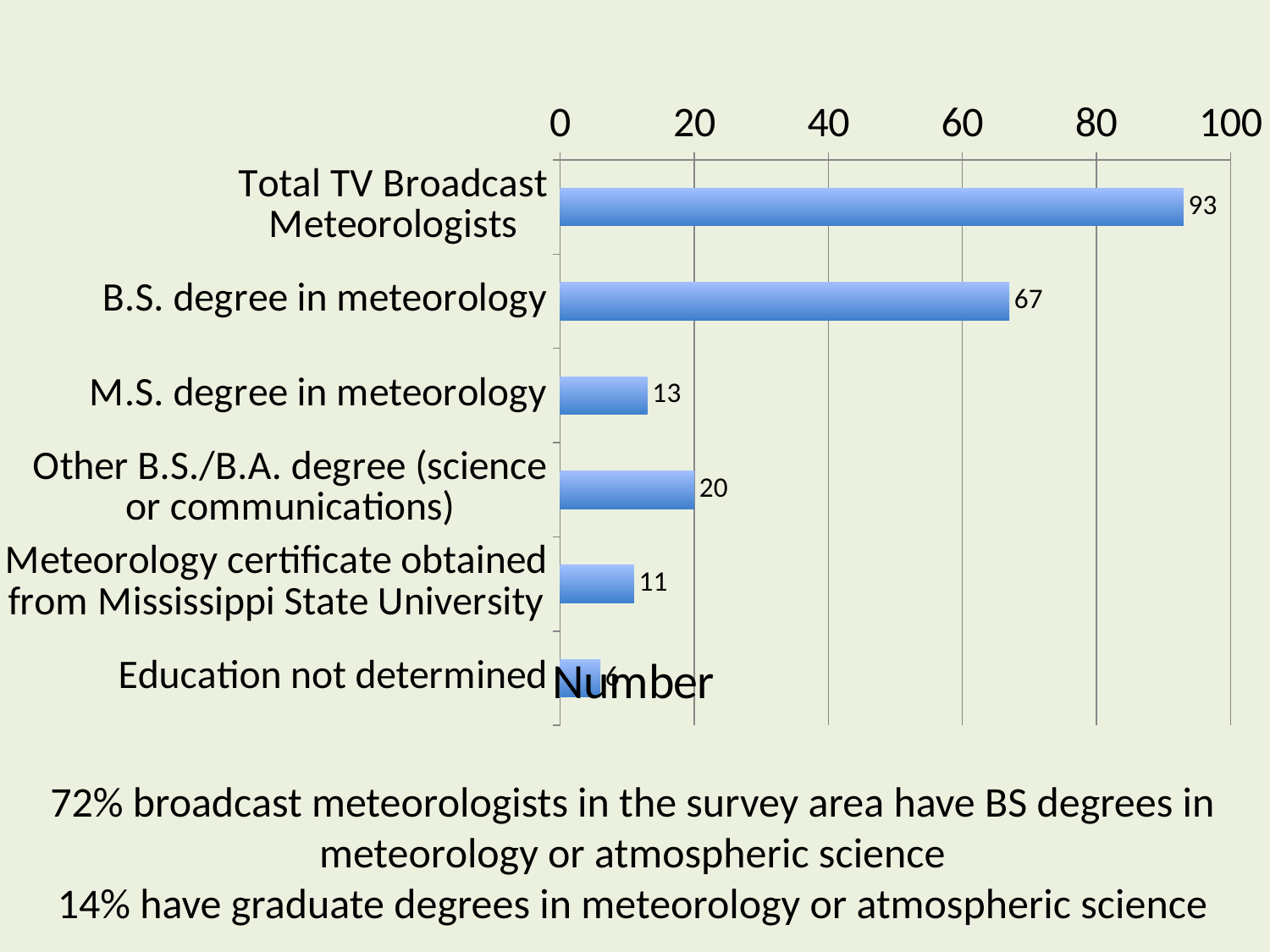
Which category has the highest value? Total TV Broadcast Meteorologists Which category has the lowest value? Education not determined What is the value for B.S. degree in meteorology? 67 What is the value for M.S. degree in meteorology? 13 What is the difference between Total TV Broadcast Meteorologists and B.S. degree in meteorology? 26 How many categories are shown in the chart? 6 What kind of chart is shown on the slide? bar chart What is the value for Total TV Broadcast Meteorologists? 93 What is the value for Other B.S./B.A. degree (science or communications)? 20 Which is larger, M.S. degree in meteorology or Other B.S./B.A. degree (science or communications)? Other B.S./B.A. degree (science or communications) What is the value for Meteorology certificate obtained from Mississippi State University? 11 Is the value for Education not determined greater or less than 20? less